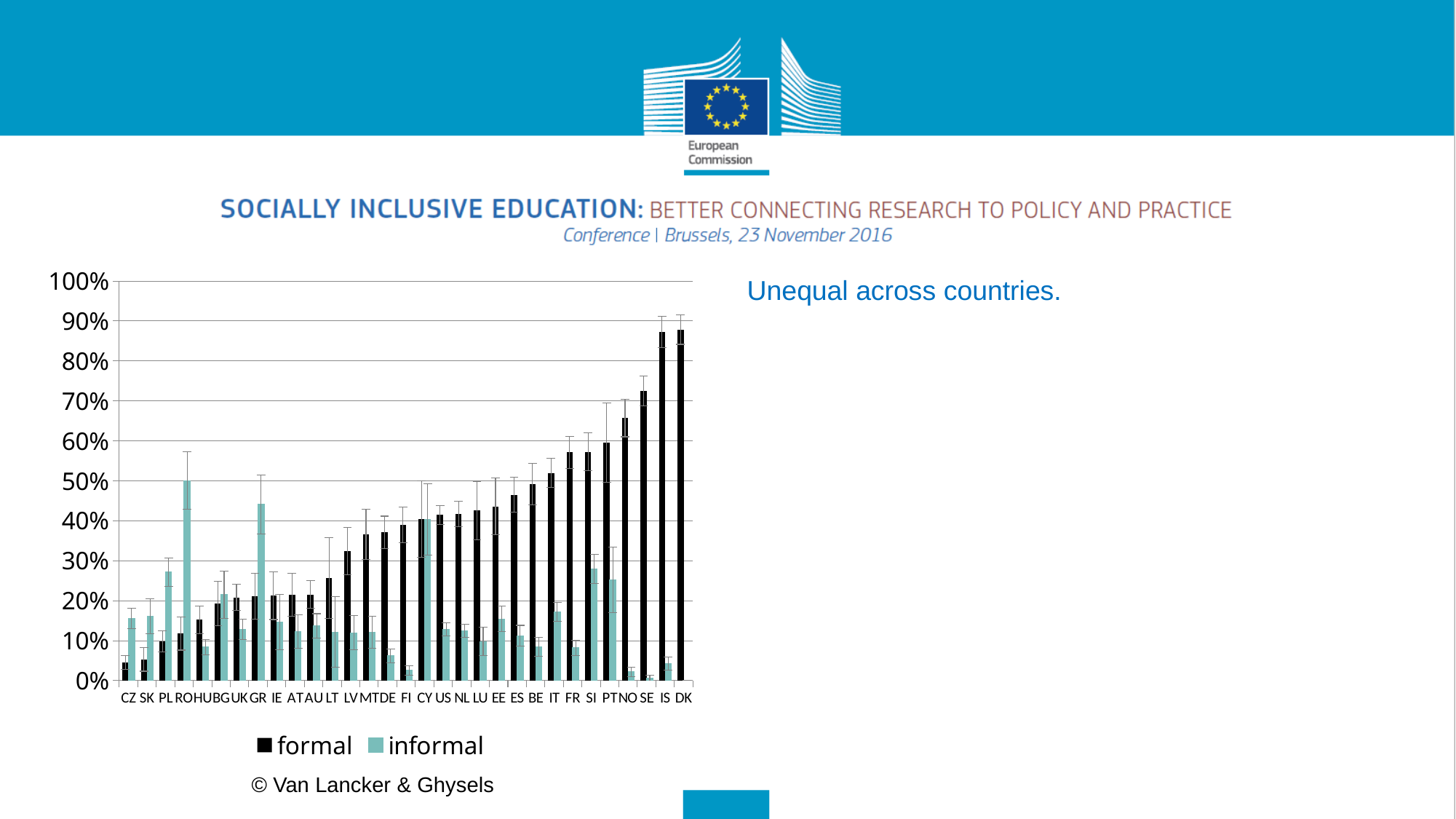
How many series does the legend list? 2 Is the formal value for CZ greater or less than 10%? less Is the informal value for RO greater or less than 40%? greater Which is larger, the formal value for SE or the formal value for NO? SE Is the formal value for SE greater or less than 70%? greater Do the formal values generally rise or fall from left to right along the x axis? rise How many countries are shown on the x axis of the chart? 31 Which country has the highest informal value? RO What kind of chart is shown on the slide? bar chart What are the two series named in the legend? formal and informal For RO, which is larger, the formal value or the informal value? informal